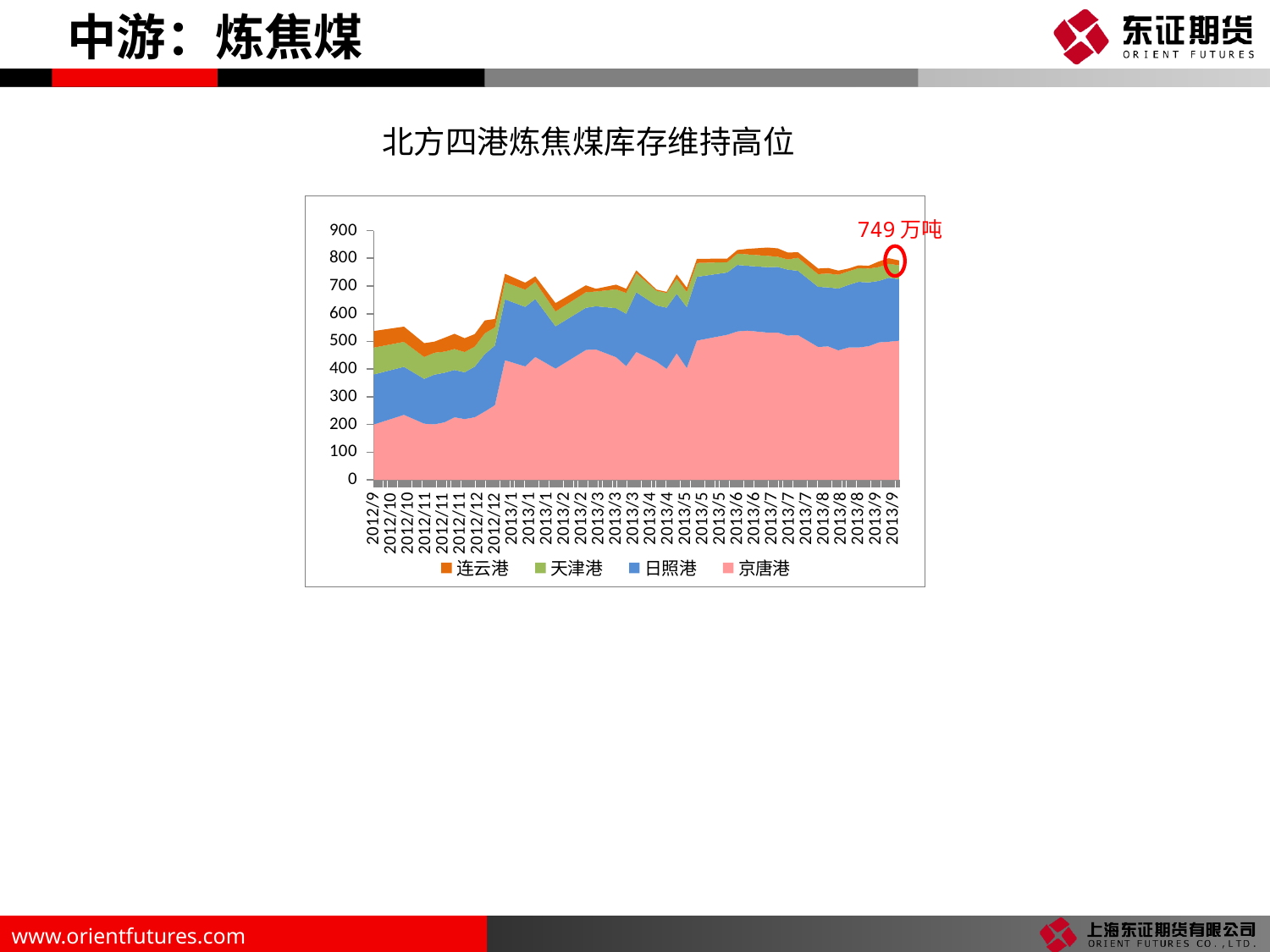
Which series occupies the smallest area of the stack? 连云港 Is the value for 京唐港 at 2013/6 greater or less than 500? greater Is the value for 京唐港 at 2012/9 greater or less than 300? less Is the total stacked value at 2012/9 greater or less than 400? greater What is the title of the chart? 北方四港炼焦煤库存维持高位 Which series occupies the largest area of the stack? 京唐港 What total value is annotated at the end of the series (2013/9)? 749 万吨 What kind of chart is shown on the slide? stacked area chart How many series does the legend list? 4 Does the value for 京唐港 rise or fall from 2012/9 to 2013/9? rise Which series is plotted at the bottom of the stack? 京唐港